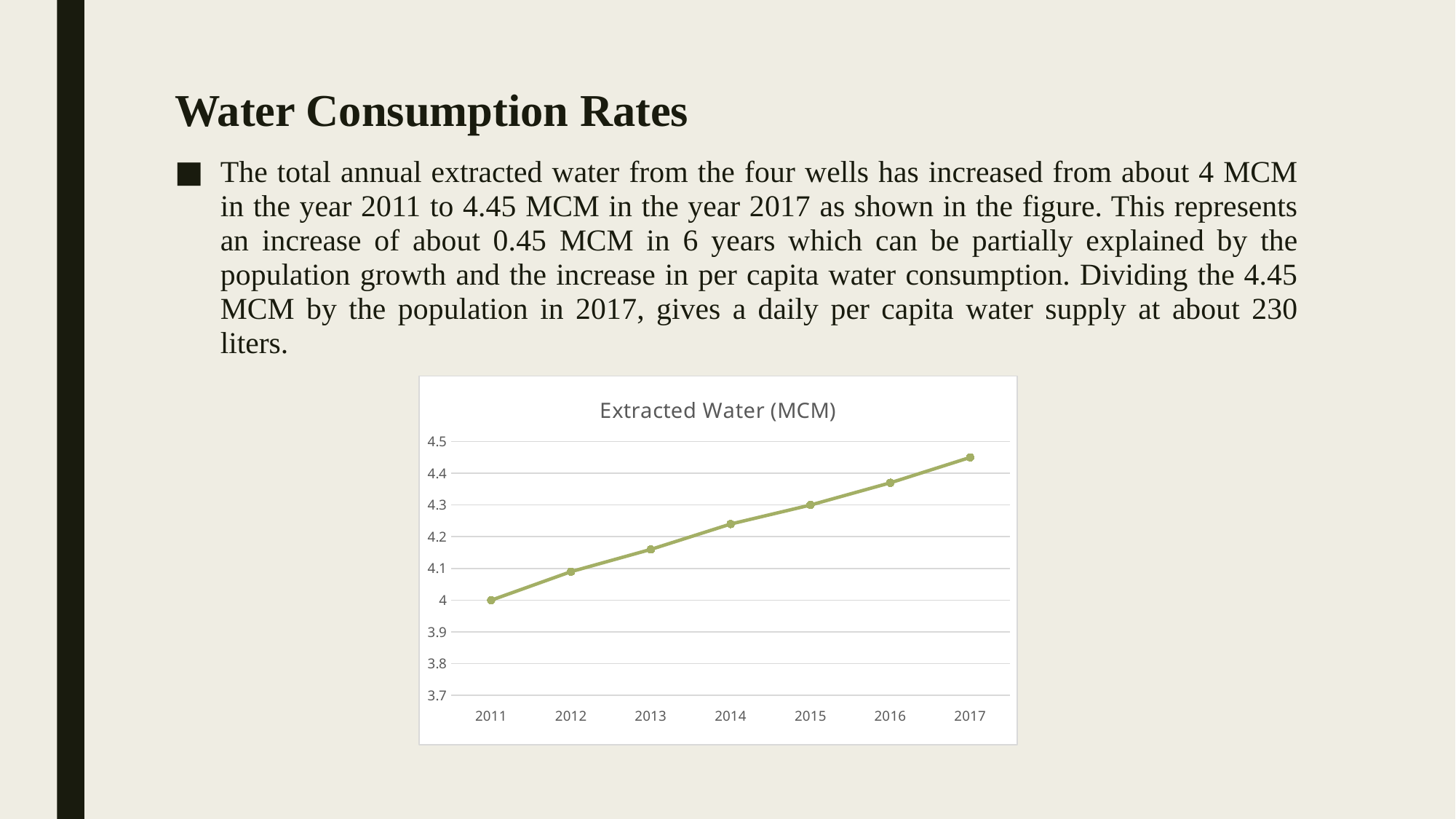
How many data points are plotted on the chart? 7 Do the extracted water values rise or fall from 2011 to 2017? rise What is the title of the chart? Extracted Water (MCM) Is the value for 2013 greater or less than 4.1? greater Which year has a larger extracted water value, 2013 or 2016? 2016 What is the extracted water value for 2011? 4 Is the value for 2017 greater or less than 4.4? greater Is the value for 2016 greater or less than 4.4? less What is the extracted water value for 2015? 4.3 What type of chart is shown on the slide? line chart Which year has the lowest extracted water value? 2011 Which year has the highest extracted water value? 2017